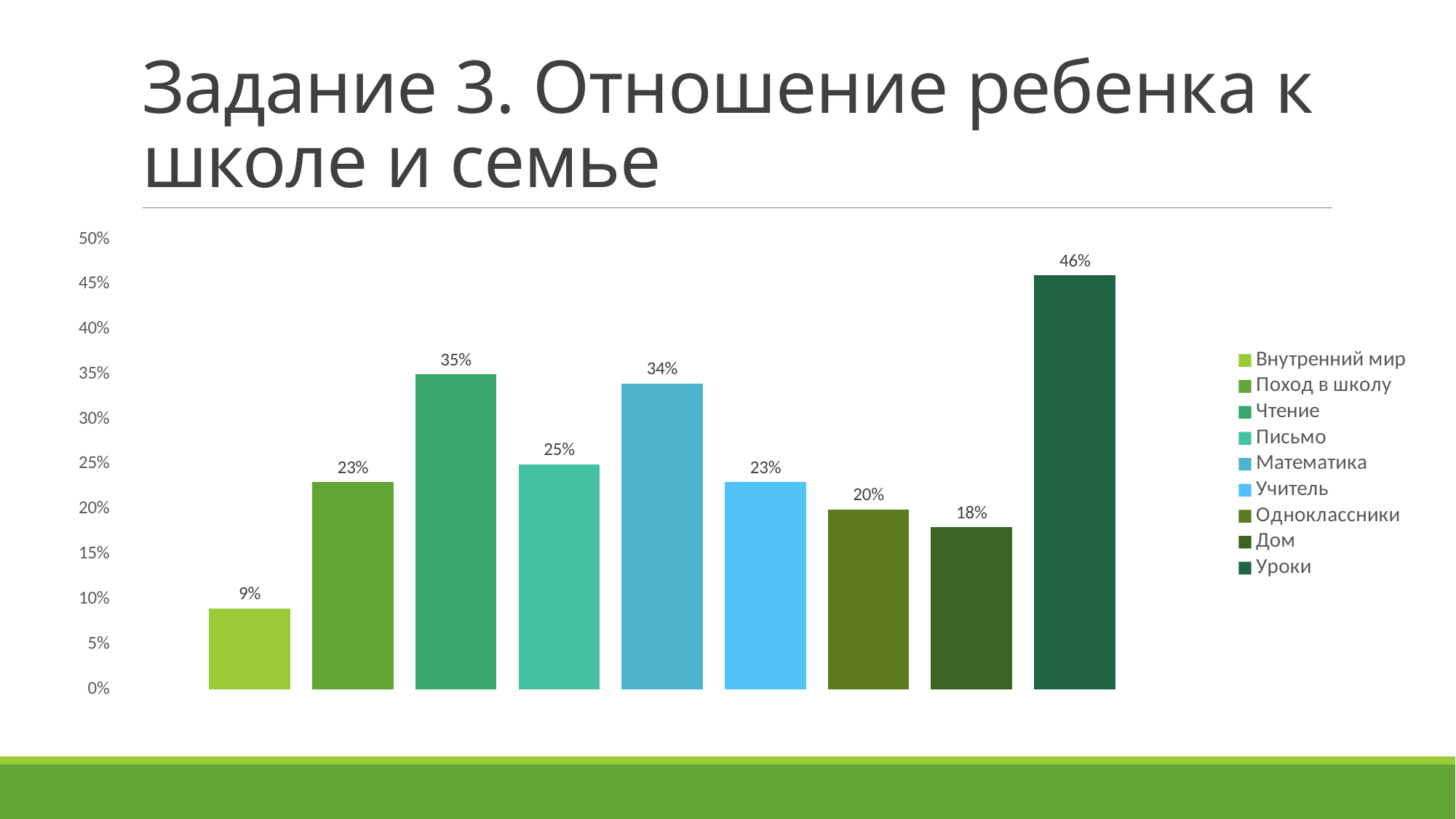
How many entries does the legend list? 9 Which is larger, the value for Письмо or the value for Одноклассники? Письмо What kind of chart is shown on the slide? bar chart What is the value for Внутренний мир? 9% What is the difference between the values for Уроки and Чтение? 11% Which category has the highest value? Уроки Which category has the lowest value? Внутренний мир What is the value for Дом? 18% Is the value for Чтение greater or less than 30%? greater What is the value for Уроки? 46% How many categories are shown in the chart? 9 What is the value for Математика? 34%